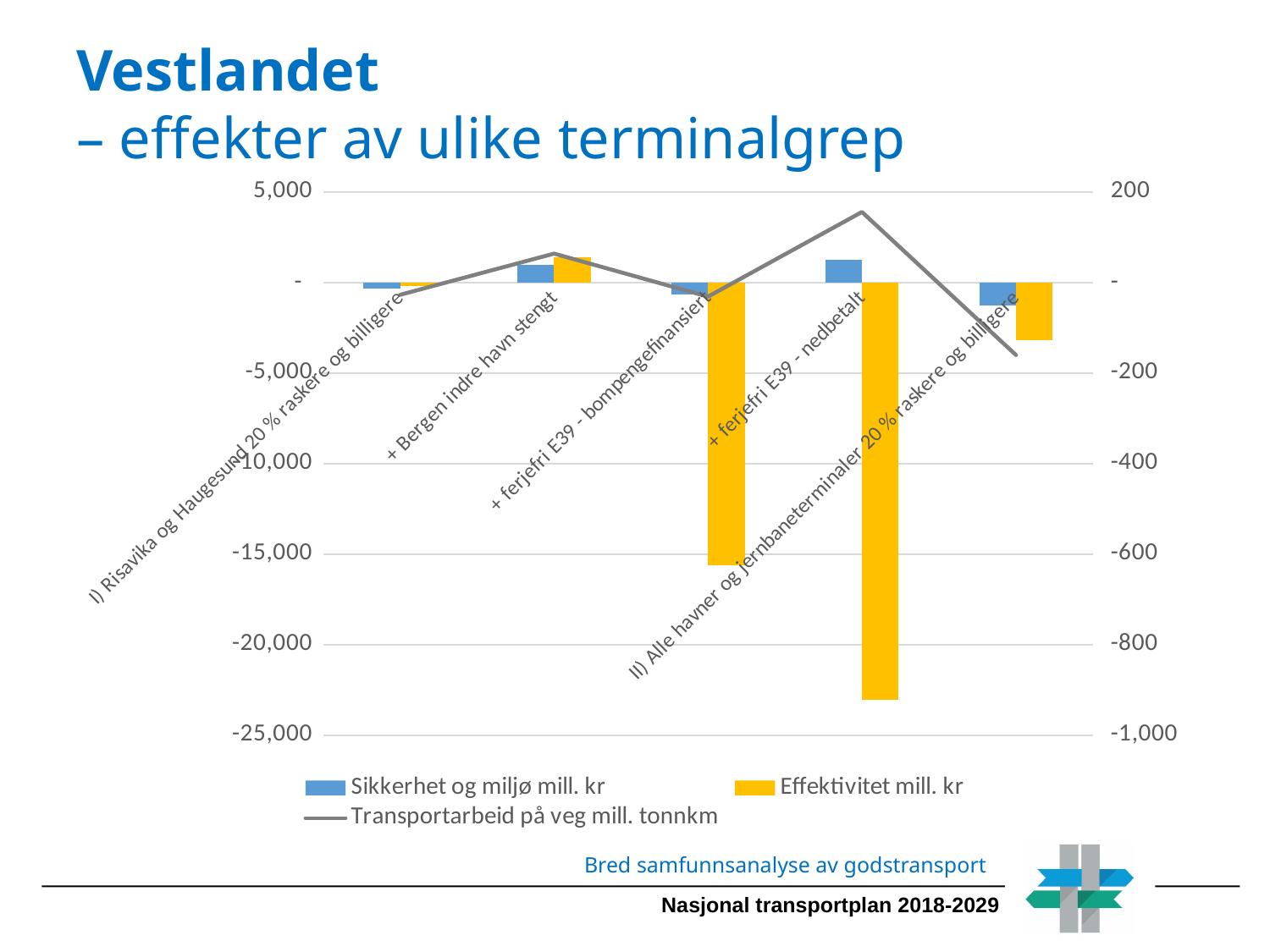
Is the Effektivitet mill. kr value for "+ ferjefri E39 - bompengefinansiert" greater or less than -10,000? less Which has the lower Effektivitet mill. kr value: "+ ferjefri E39 - bompengefinansiert" or "+ ferjefri E39 - nedbetalt"? + ferjefri E39 - nedbetalt Is the Effektivitet mill. kr value for "+ ferjefri E39 - nedbetalt" greater or less than -20,000? less How many categories are plotted along the x axis? 5 What colour are the Effektivitet mill. kr bars? yellow Which has the larger Sikkerhet og miljø mill. kr value: "+ ferjefri E39 - nedbetalt" or "II) Alle havner og jernbaneterminaler 20 % raskere og billigere"? + ferjefri E39 - nedbetalt At which category does the Transportarbeid på veg mill. tonnkm line reach its lowest point? II) Alle havner og jernbaneterminaler 20 % raskere og billigere What kind of chart is shown on the slide? bar chart with a line series At which category does the Transportarbeid på veg mill. tonnkm line reach its highest point? + ferjefri E39 - nedbetalt Which category has the lowest value for Effektivitet mill. kr? + ferjefri E39 - nedbetalt Is the Effektivitet mill. kr value for "II) Alle havner og jernbaneterminaler 20 % raskere og billigere" greater or less than -5,000? greater How many series does the legend list? 3